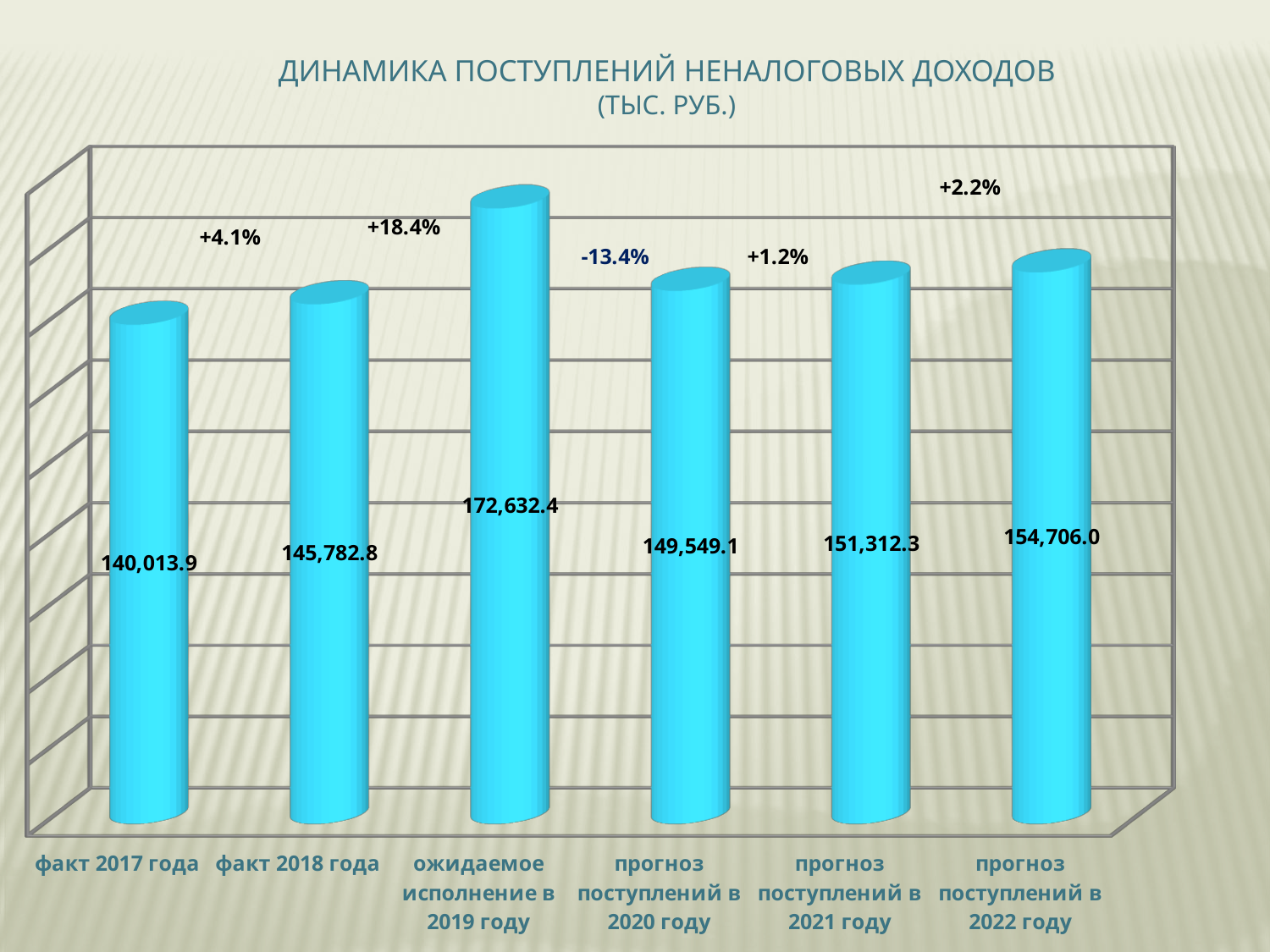
What kind of chart is shown on the slide? bar chart Which category has the highest value? ожидаемое исполнение в 2019 году What is the value for "факт 2017 года"? 140,013.9 How many categories are shown on the chart? 6 What is the difference between the values for "ожидаемое исполнение в 2019 году" and "факт 2017 года"? 32,618.5 What unit is given in the chart title? тыс. руб. Which is larger, the value for "факт 2018 года" or the value for "прогноз поступлений в 2020 году"? прогноз поступлений в 2020 году Which category has the lowest value? факт 2017 года What is the value for "прогноз поступлений в 2020 году"? 149,549.1 What is the value for "ожидаемое исполнение в 2019 году"? 172,632.4 What is the value for "прогноз поступлений в 2022 году"? 154,706.0 What is the difference between the values for "прогноз поступлений в 2021 году" and "прогноз поступлений в 2020 году"? 1,763.2